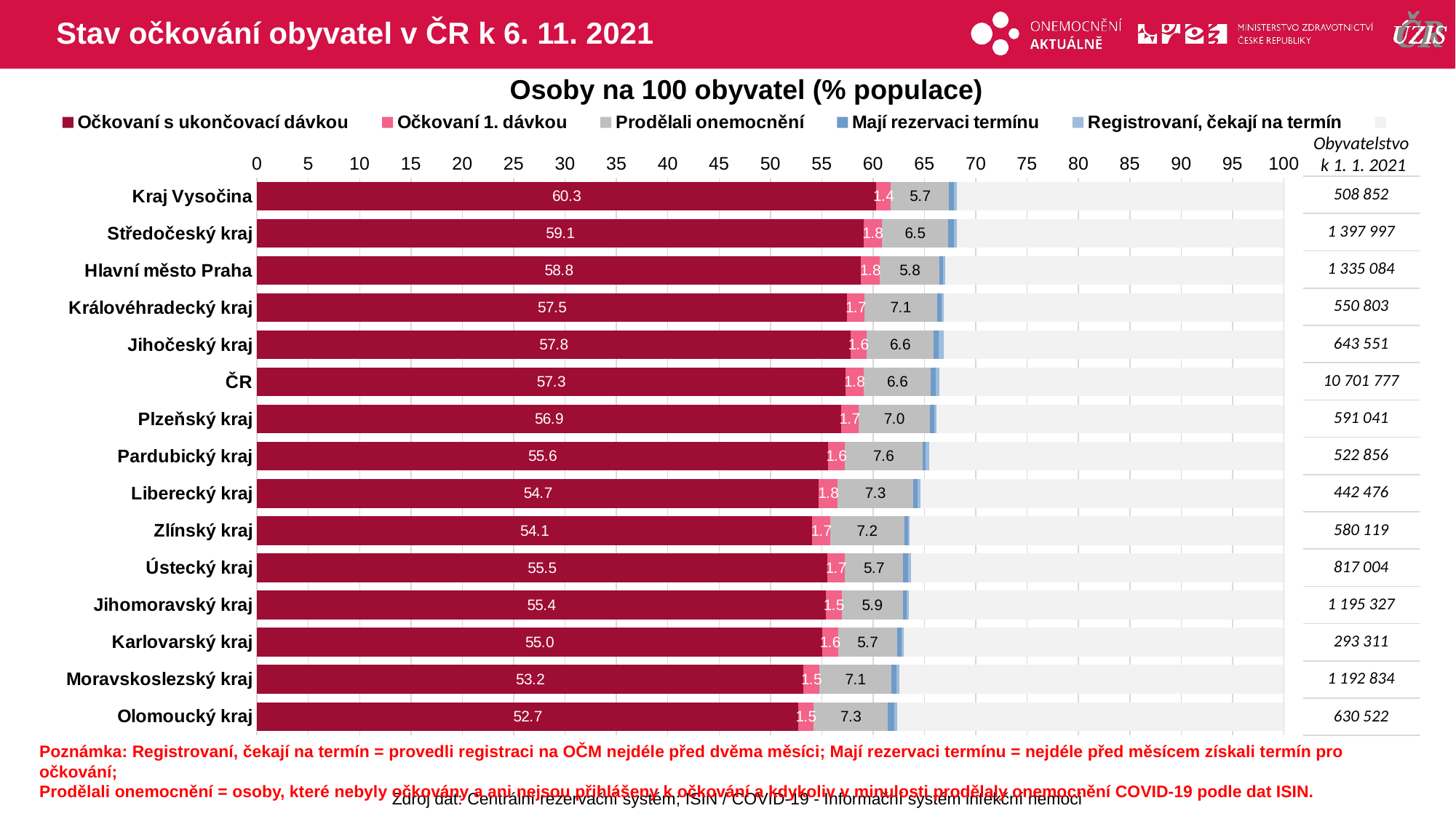
What is the difference in 'Očkovaní s ukončovací dávkou' between Kraj Vysočina and Olomoucký kraj? 7.6 How many categories (rows) are plotted in the chart? 15 How many labelled series does the legend list? 5 What kind of chart is shown on the slide? Stacked bar chart Which has a higher value of 'Očkovaní s ukončovací dávkou': Jihočeský kraj or Královéhradecký kraj? Jihočeský kraj Which category has the highest value of 'Očkovaní s ukončovací dávkou'? Kraj Vysočina What is the value of 'Očkovaní 1. dávkou' for ČR? 1.8 What is the value of 'Očkovaní s ukončovací dávkou' for Kraj Vysočina? 60.3 What is the title of the chart? Osoby na 100 obyvatel (% populace) What is the value of 'Prodělali onemocnění' for Olomoucký kraj? 7.3 Which category has the lowest value of 'Očkovaní s ukončovací dávkou'? Olomoucký kraj Which category has the highest value of 'Prodělali onemocnění'? Pardubický kraj